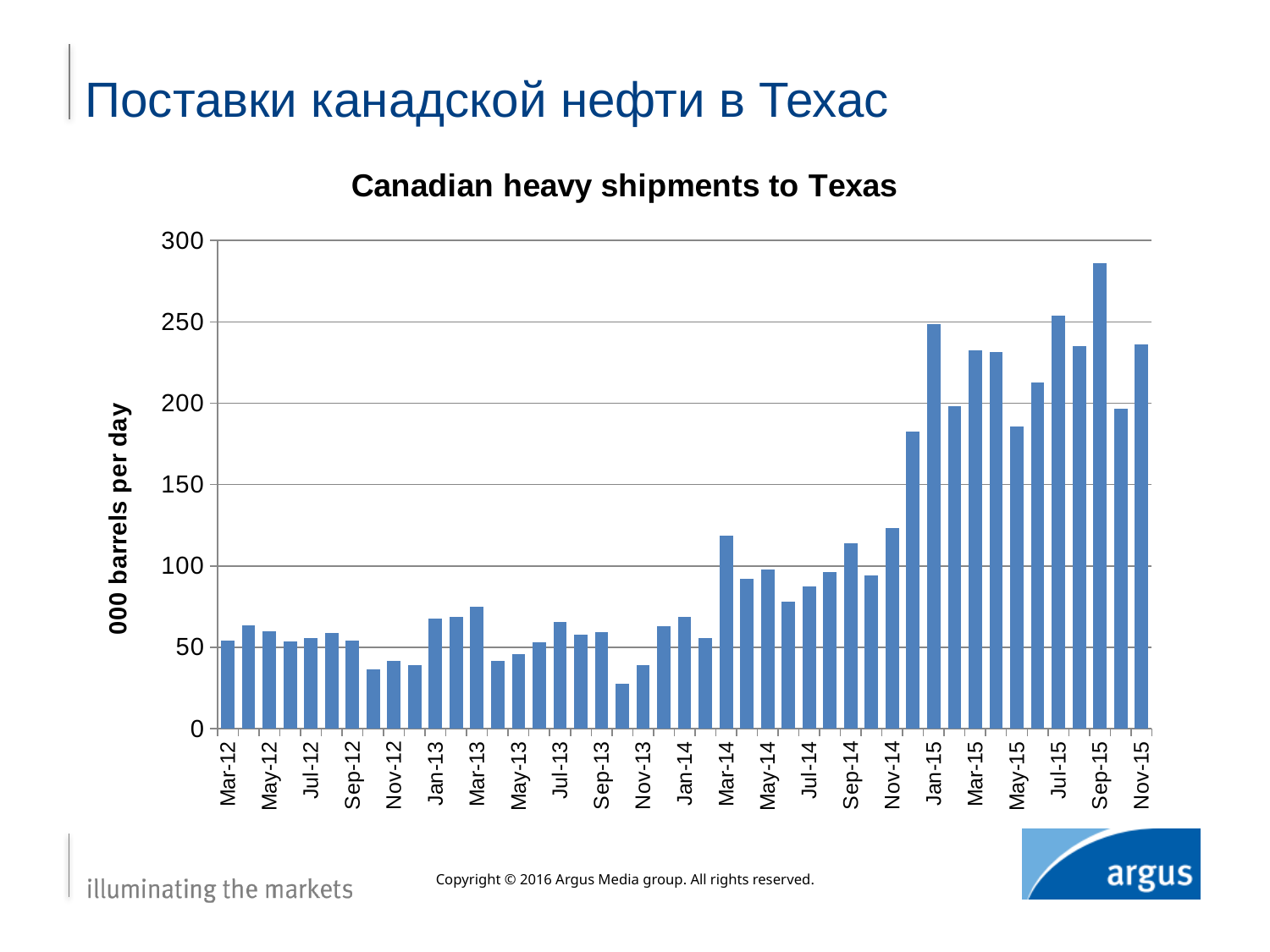
Is the value for Mar-12 greater or less than 100? less What is the title of the chart? Canadian heavy shipments to Texas Is the value for May-15 greater or less than 200? less Is the value for Nov-13 greater or less than 50? less What is the label on the vertical axis of the chart? 000 barrels per day What kind of chart is shown on the slide? bar chart Overall, do the values rise or fall from Mar-12 to Nov-15? rise Which is larger, the value for Jan-15 or the value for Jan-14? Jan-15 Which labeled month has the highest value in the chart? Sep-15